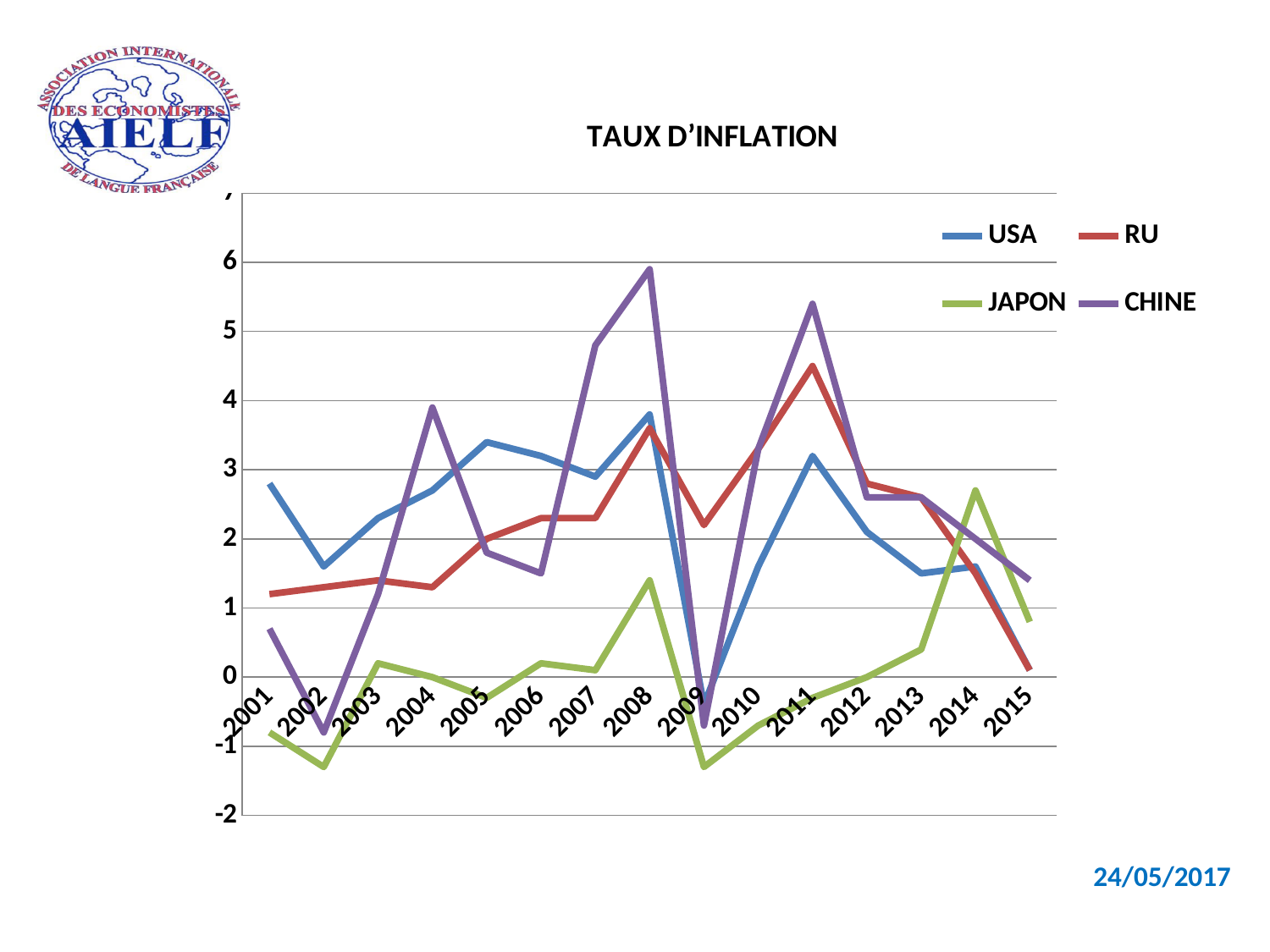
Which series has the lowest value in 2009? JAPON Is the value for JAPON in 2002 greater or less than -1? less How many series does the legend list? 4 In 2011, which is larger: the value for RU or the value for USA? RU Does the RU series rise or fall from 2011 to 2015? fall Which series has the highest value in 2008? CHINE Is the value for CHINE in 2008 greater or less than 5? greater In which year does the CHINE series reach its highest value? 2008 How many years are plotted along the x axis? 15 What is the title of the chart? TAUX D'INFLATION Is the value for USA in 2001 greater or less than 2? greater What kind of chart is shown on the slide? Line chart